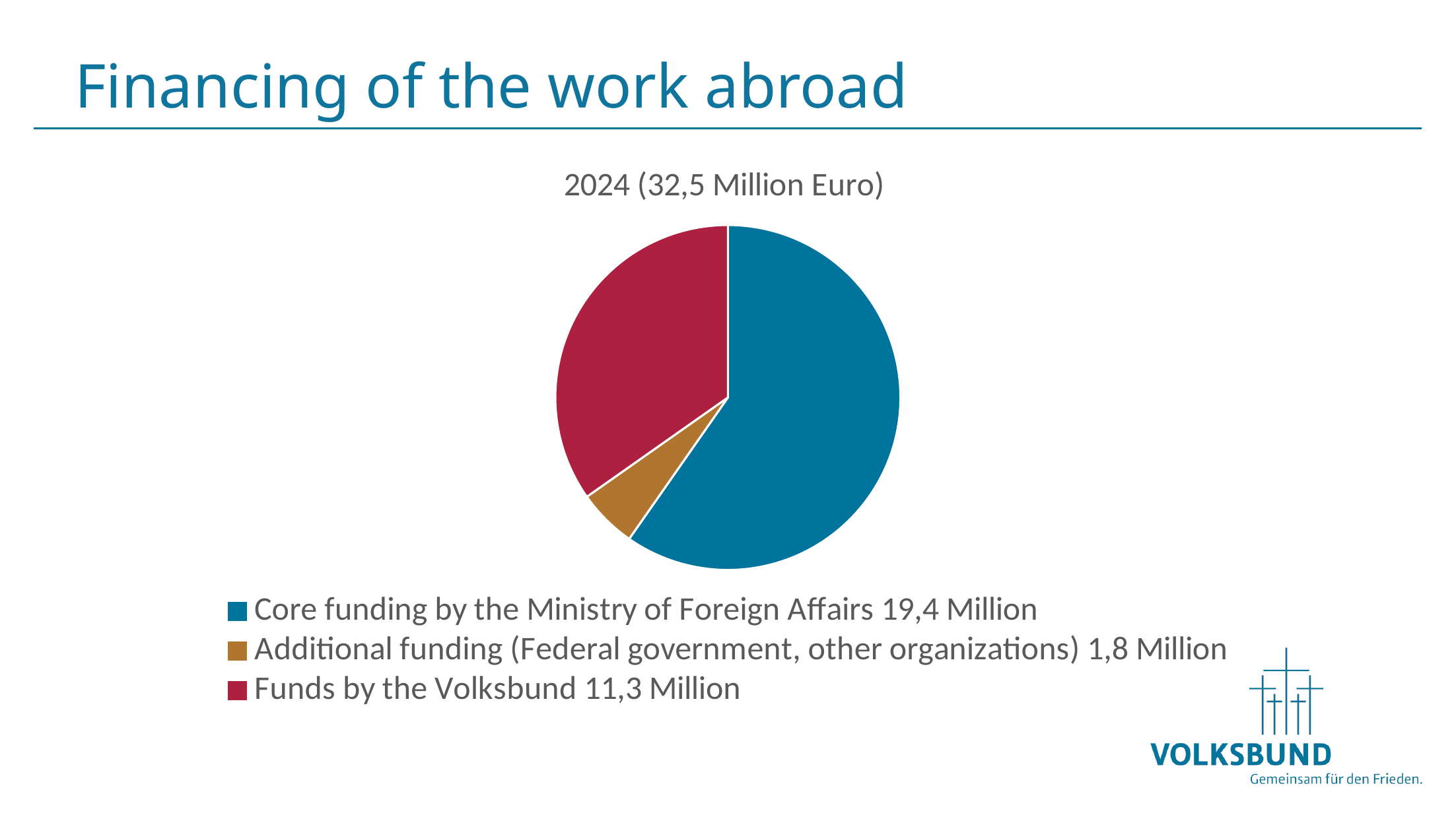
What type of chart is shown on the slide? Pie chart Which is larger: Funds by the Volksbund or Additional funding (Federal government, other organizations)? Funds by the Volksbund What is the value for Core funding by the Ministry of Foreign Affairs? 19,4 Million What is the value for Funds by the Volksbund? 11,3 Million How many slices does the pie chart have? 3 Which funding source has the largest slice of the pie? Core funding by the Ministry of Foreign Affairs What is the total amount shown in the chart title for 2024? 32,5 Million Euro What colour is the slice for Funds by the Volksbund? Red What is the difference between Core funding by the Ministry of Foreign Affairs and Funds by the Volksbund? 8,1 Million What is the difference between Funds by the Volksbund and Additional funding (Federal government, other organizations)? 9,5 Million What is the value for Additional funding (Federal government, other organizations)? 1,8 Million Which funding source has the smallest slice of the pie? Additional funding (Federal government, other organizations)